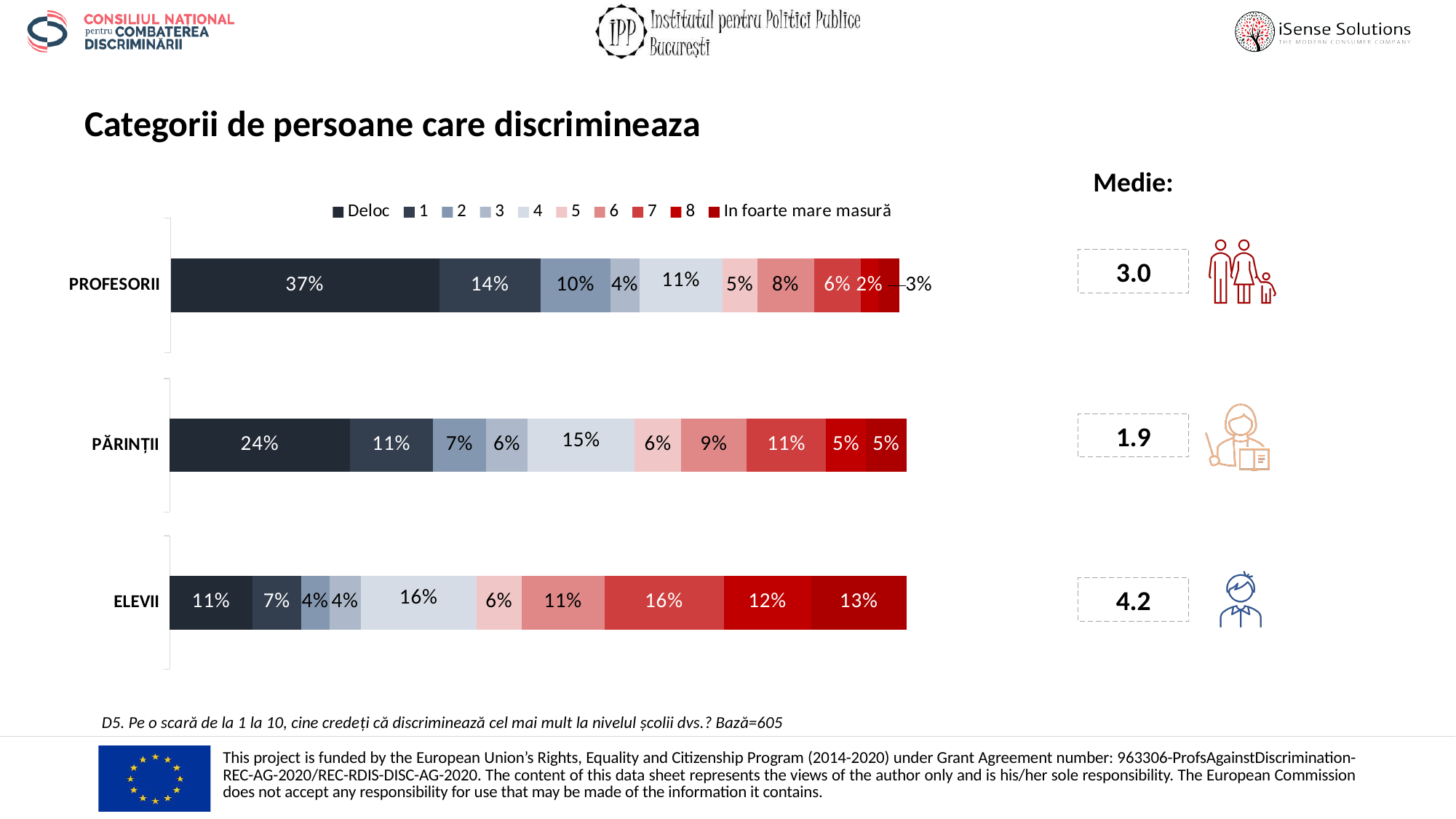
Which category has the lowest 'In foarte mare masură' value? PROFESORII How many series does the chart legend list? 10 What is the total of the stacked bar for PĂRINȚII? 99% How many categories are shown on the chart? 3 Which is larger: the '8' value for ELEVII or the '8' value for PĂRINȚII? ELEVII Which category has the highest 'Deloc' value? PROFESORII What is the difference between the 'Deloc' values for PROFESORII and PĂRINȚII? 13% What is the 'Deloc' value for PROFESORII? 37% What is the 'In foarte mare masură' value for ELEVII? 13% What is the value for series '4' for PĂRINȚII? 15% What is the value for series '7' for ELEVII? 16% What kind of chart is shown on the slide? Stacked bar chart